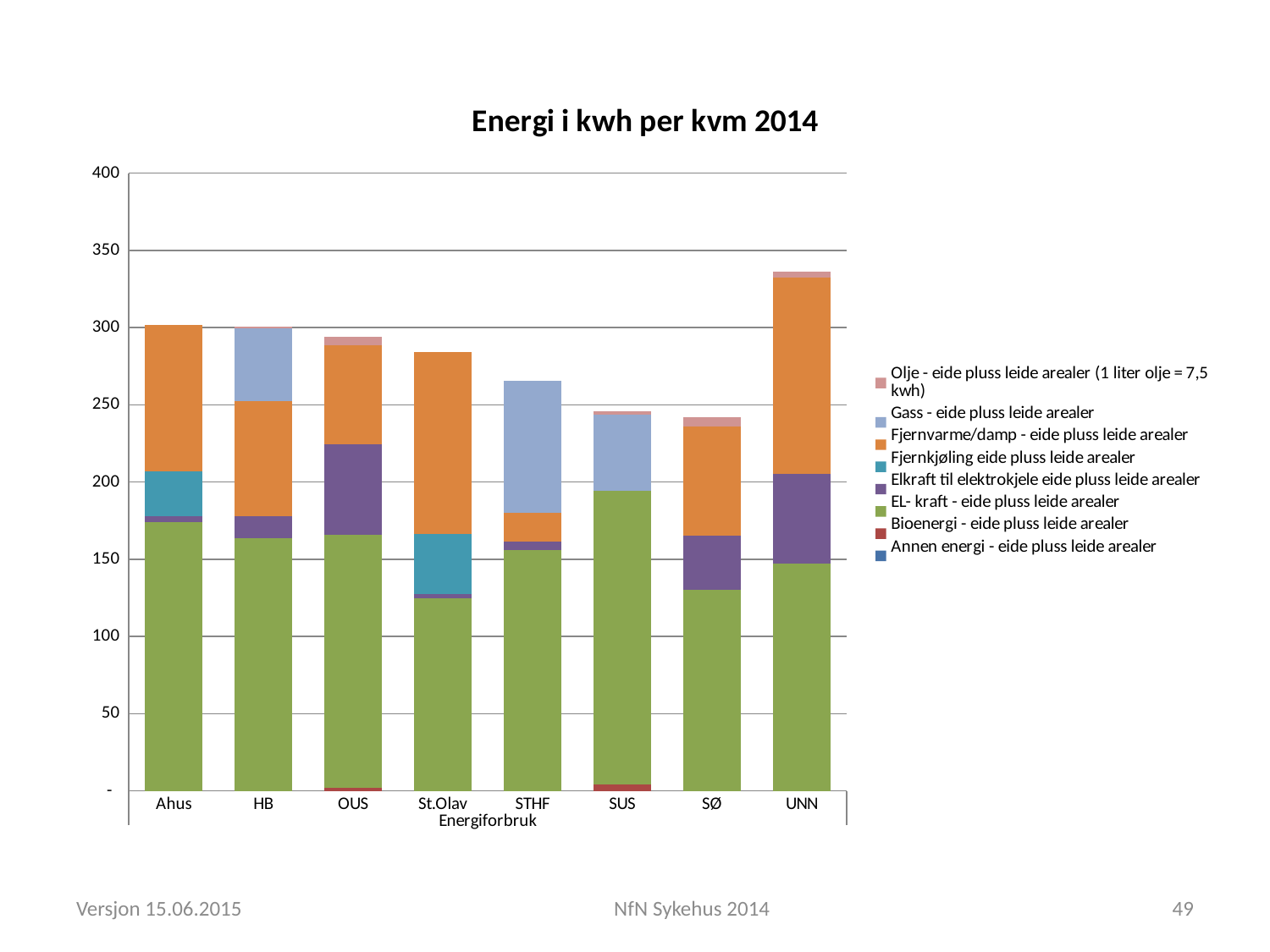
How many series does the legend list? 8 Which has the larger total, UNN or STHF? UNN Which hospital has the highest total energy use per kvm? UNN Is the EL-kraft (green) segment for SØ greater or less than 150? less Is the total value for St.Olav greater or less than 300? less Is the total value for STHF greater or less than 300? less How many hospitals (categories) are shown on the x axis? 8 Which has the larger total, Ahus or SUS? Ahus What is the title of the chart? Energi i kwh per kvm 2014 What kind of chart is shown on the slide? Stacked bar chart